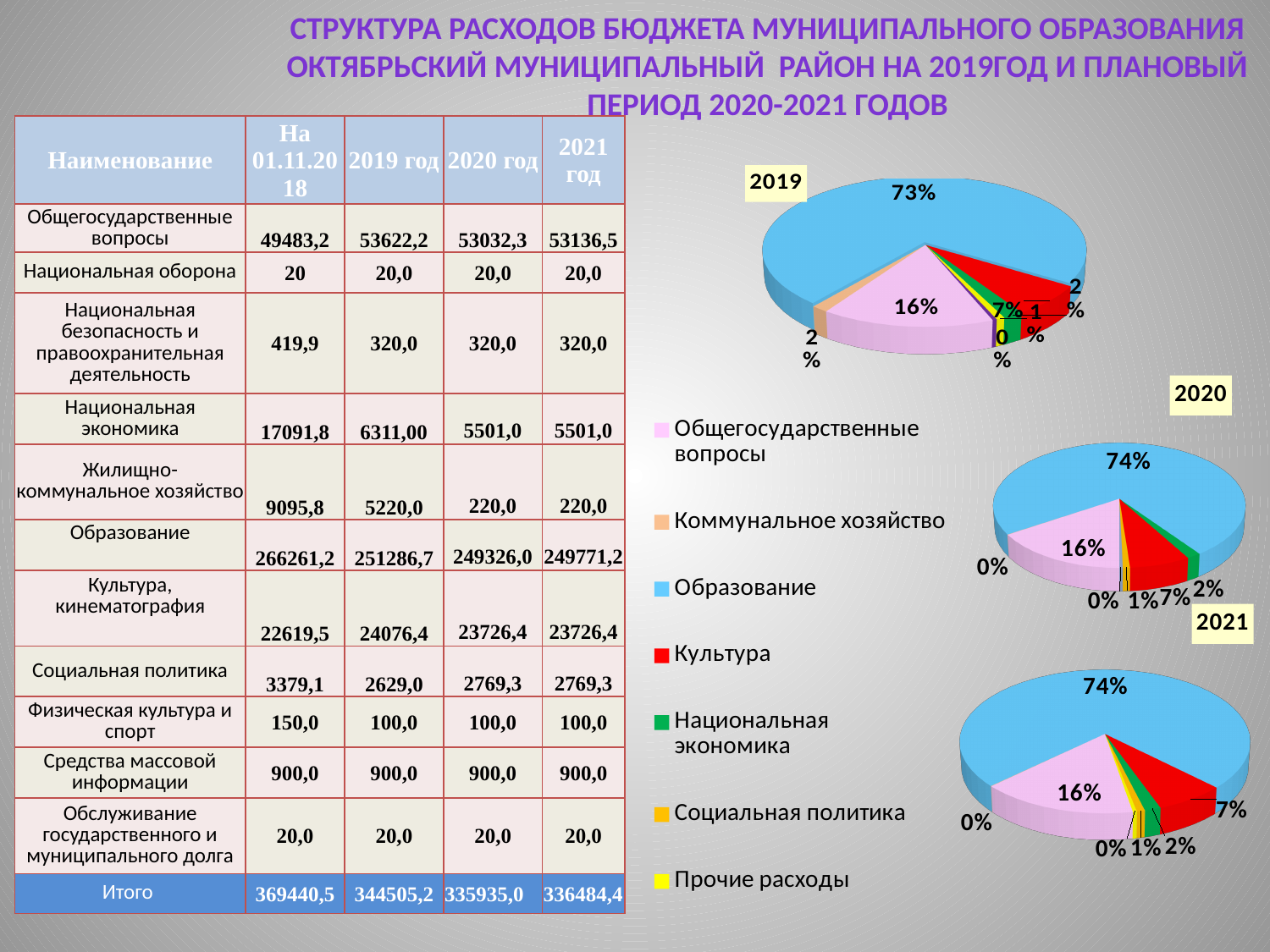
In the 2019 pie chart, what share does Общегосударственные вопросы (the pink slice) have? 16% In the 2020 pie chart, what share does Образование (the blue slice) have? 74% How many pie charts are shown on the slide? 3 What kind of chart is used for the 2019 chart on the right of the slide? pie chart In the 2021 pie chart, what share does Общегосударственные вопросы (the pink slice) have? 16% How many entries does the shared legend of the pie charts list? 7 In the 2020 pie chart, which category has the largest slice? Образование In the 2019 pie chart, which is larger: the slice for Общегосударственные вопросы or the slice for Культура? Общегосударственные вопросы In the 2019 pie chart, what is the difference in percentage points between the Образование slice and the Общегосударственные вопросы slice? 57